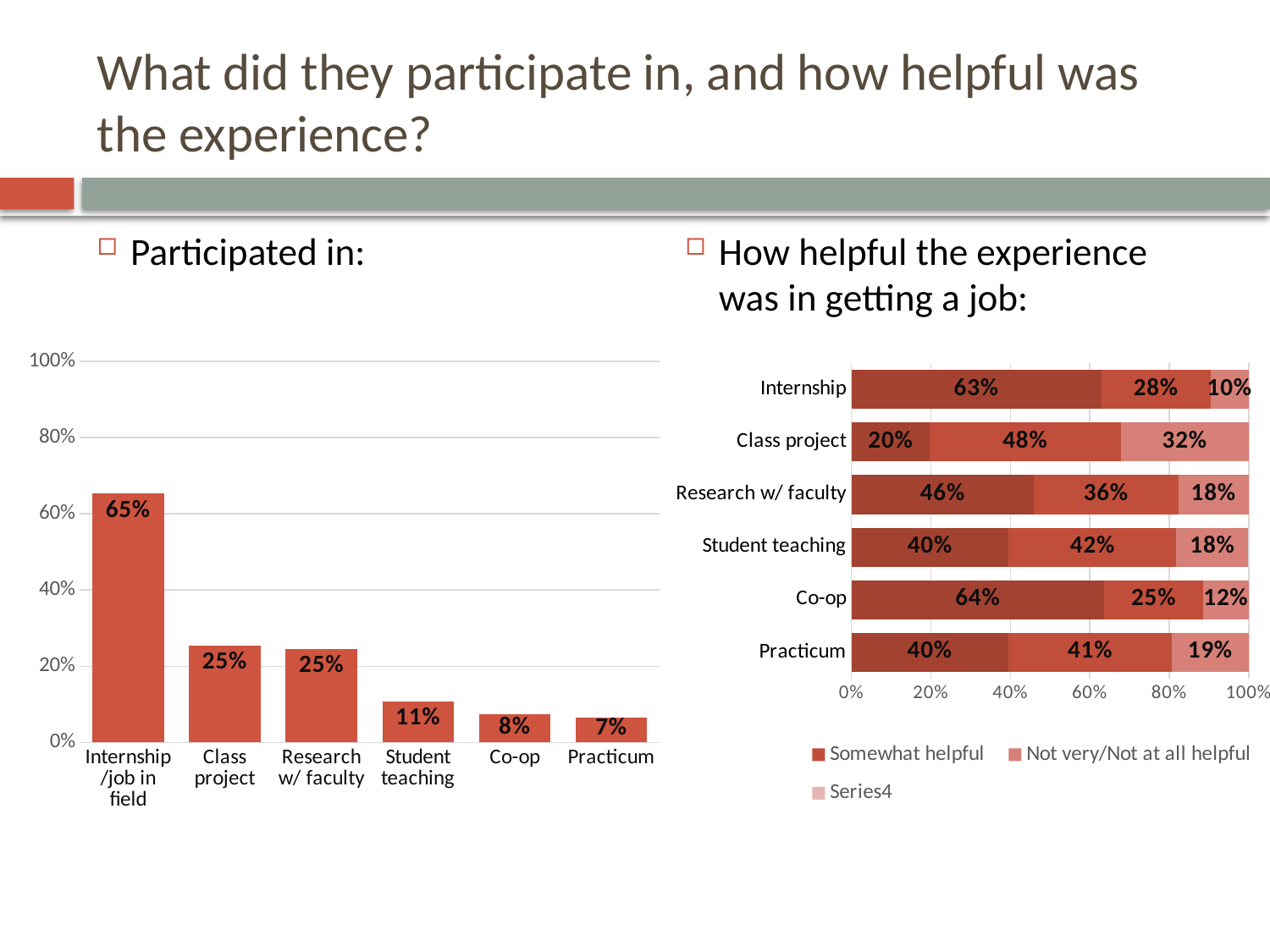
In the 'Participated in' chart on the left, do the values rise or fall from left to right along the x axis? Fall How many series does the legend list in the 'How helpful the experience was in getting a job' chart on the right? 3 In the 'Participated in' chart on the left, which category has the lowest value? Practicum What kind of chart is the 'How helpful the experience was in getting a job' chart on the right? Stacked bar chart In the 'Participated in' chart on the left, which category has the highest value? Internship/job in field In the 'Participated in' chart on the left, what percentage participated in an Internship/job in field? 65% In the 'Participated in' chart on the left, what is the difference between the Internship/job in field value and the Class project value? 40 percentage points What kind of chart is the 'Participated in' chart on the left? Bar chart How many categories are shown in the 'Participated in' chart on the left? 6